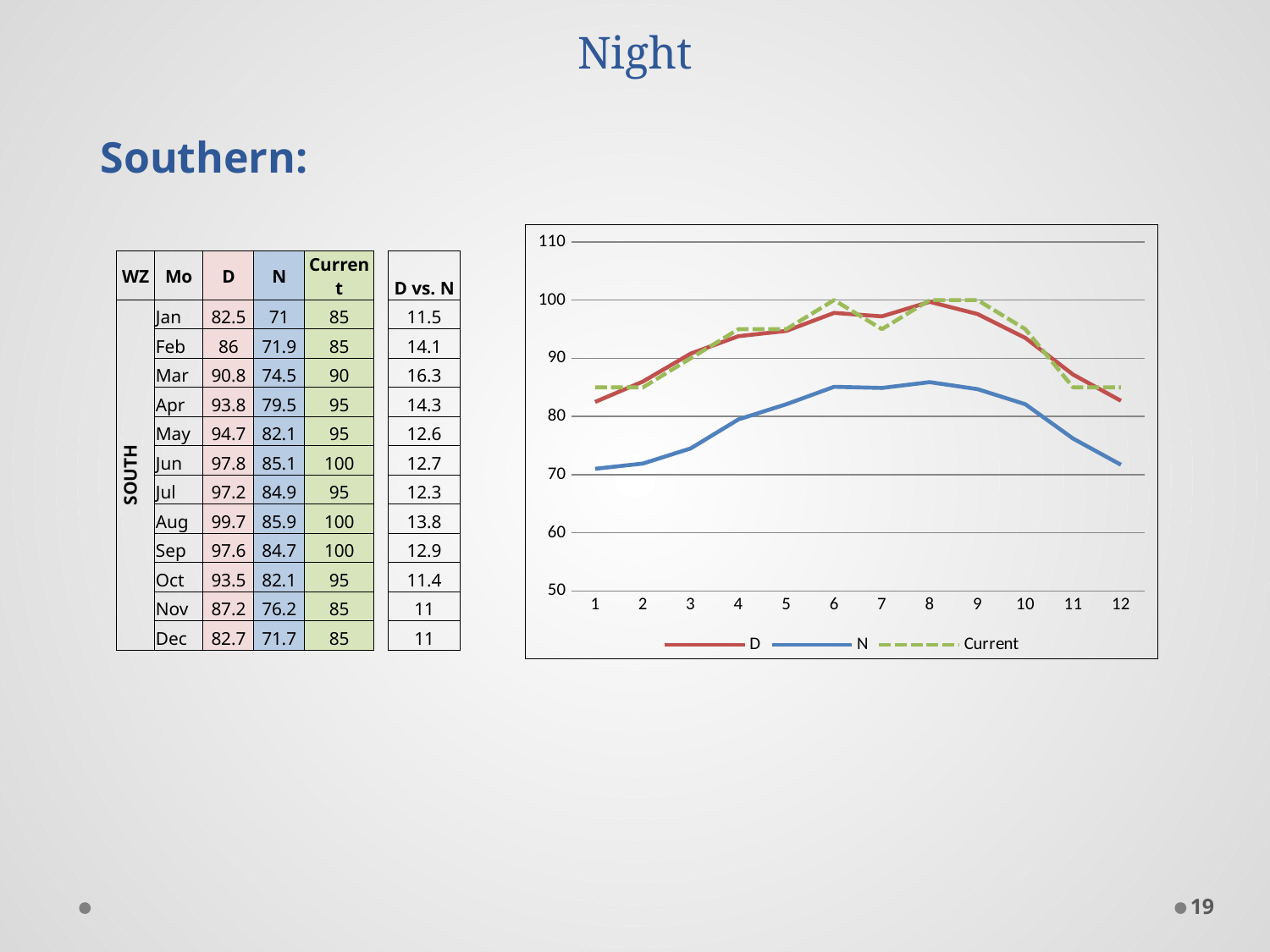
Which series in the chart is drawn with a dashed line? Current At x = 4, which series has the larger value, D or N? D Is the value of the N series at x = 6 greater or less than 80? greater Does the N series rise or fall from x = 1 to x = 8? rise How many series does the chart legend list? 3 Does the D series rise or fall from x = 8 to x = 12? fall Is the value of the D series at x = 8 greater or less than 90? greater At x = 6, which series has the larger value, Current or D? Current What kind of chart is shown on the slide? line chart How many points along the x axis does each line in the chart have? 12 At which x value does the N series reach its lowest point? 1 Is the value of the N series at x = 12 greater or less than 80? less